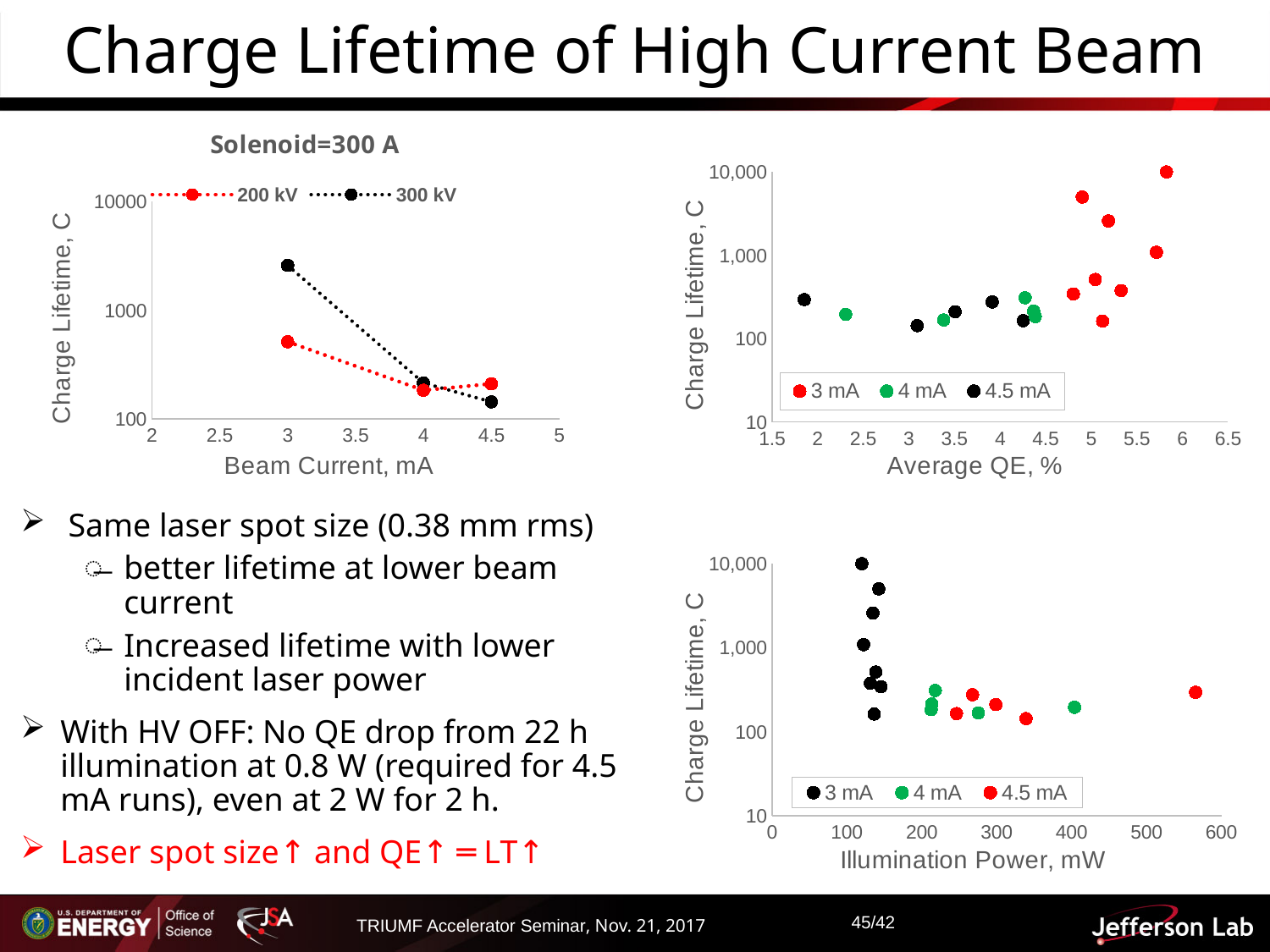
In the chart titled 'Solenoid=300 A', how many series does the legend list? 2 In the bottom-right chart (Charge Lifetime vs Illumination Power), is the charge lifetime of the 4.5 mA point near 570 mW greater or less than 1,000? less In the chart titled 'Solenoid=300 A', does the charge lifetime of the 300 kV series rise or fall as beam current increases? fall In the top-right chart (Charge Lifetime vs Average QE), which series has the point with the highest charge lifetime? 3 mA In the chart titled 'Solenoid=300 A', how many data points does the 300 kV series have? 3 In the top-right chart (Charge Lifetime vs Average QE), what is the label on the x axis? Average QE, % In the chart titled 'Solenoid=300 A', at a beam current of 3 mA, which series has the higher charge lifetime, 200 kV or 300 kV? 300 kV In the chart titled 'Solenoid=300 A', is the charge lifetime for the 300 kV series at 3 mA greater or less than 1000? greater In the top-right chart (Charge Lifetime vs Average QE), how many series does the legend list? 3 In the bottom-right chart (Charge Lifetime vs Illumination Power), which series has the point with the highest charge lifetime? 3 mA In the chart titled 'Solenoid=300 A', is the charge lifetime for the 200 kV series at 3 mA greater or less than 1000? less In the chart titled 'Solenoid=300 A', what are the two series named in the legend? 200 kV and 300 kV